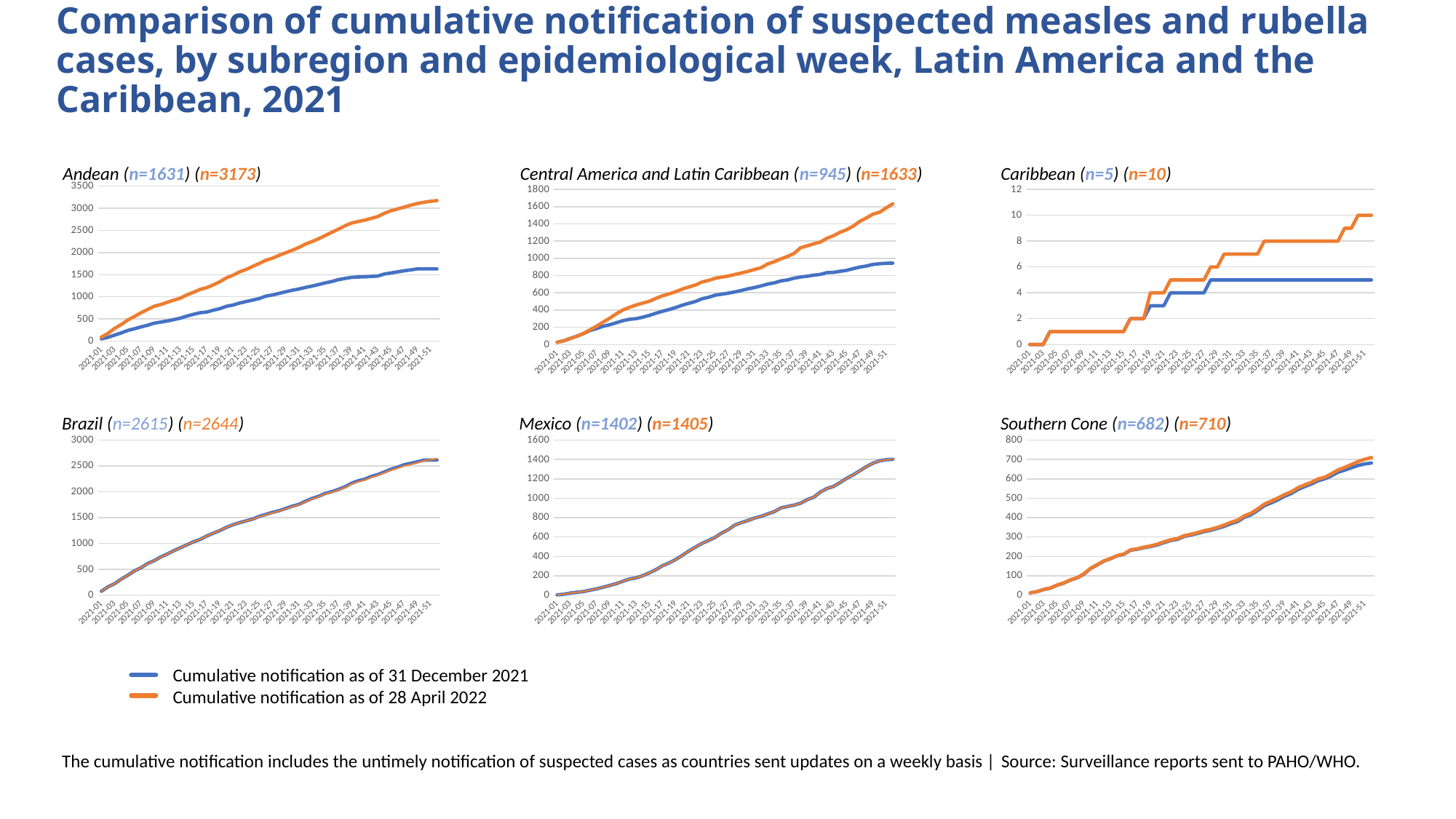
Which subregion has the highest cumulative notification as of 28 April 2022? Andean In the Caribbean chart, what is the cumulative notification as of 31 December 2021 (n)? 5 In the Andean chart, what is the difference between the cumulative notification as of 28 April 2022 and as of 31 December 2021? 1542 What colour represents the cumulative notification as of 28 April 2022 in the legend? Orange How many subregion charts are shown on the slide? 6 In the Caribbean chart, is the cumulative notification as of 28 April 2022 at week 2021-41 greater or less than 6? greater In the Mexico chart, do the cumulative notification values rise or fall across the epidemiological weeks? Rise What kind of chart is used for each subregion on this slide? Line chart In the Brazil chart, what is the difference between the cumulative notification as of 28 April 2022 and as of 31 December 2021? 29 In the Central America and Latin Caribbean chart, which series has the larger final value: as of 31 December 2021 or as of 28 April 2022? As of 28 April 2022 How many series does the legend list? 2 In the Andean chart, what is the cumulative notification as of 28 April 2022 (n)? 3173